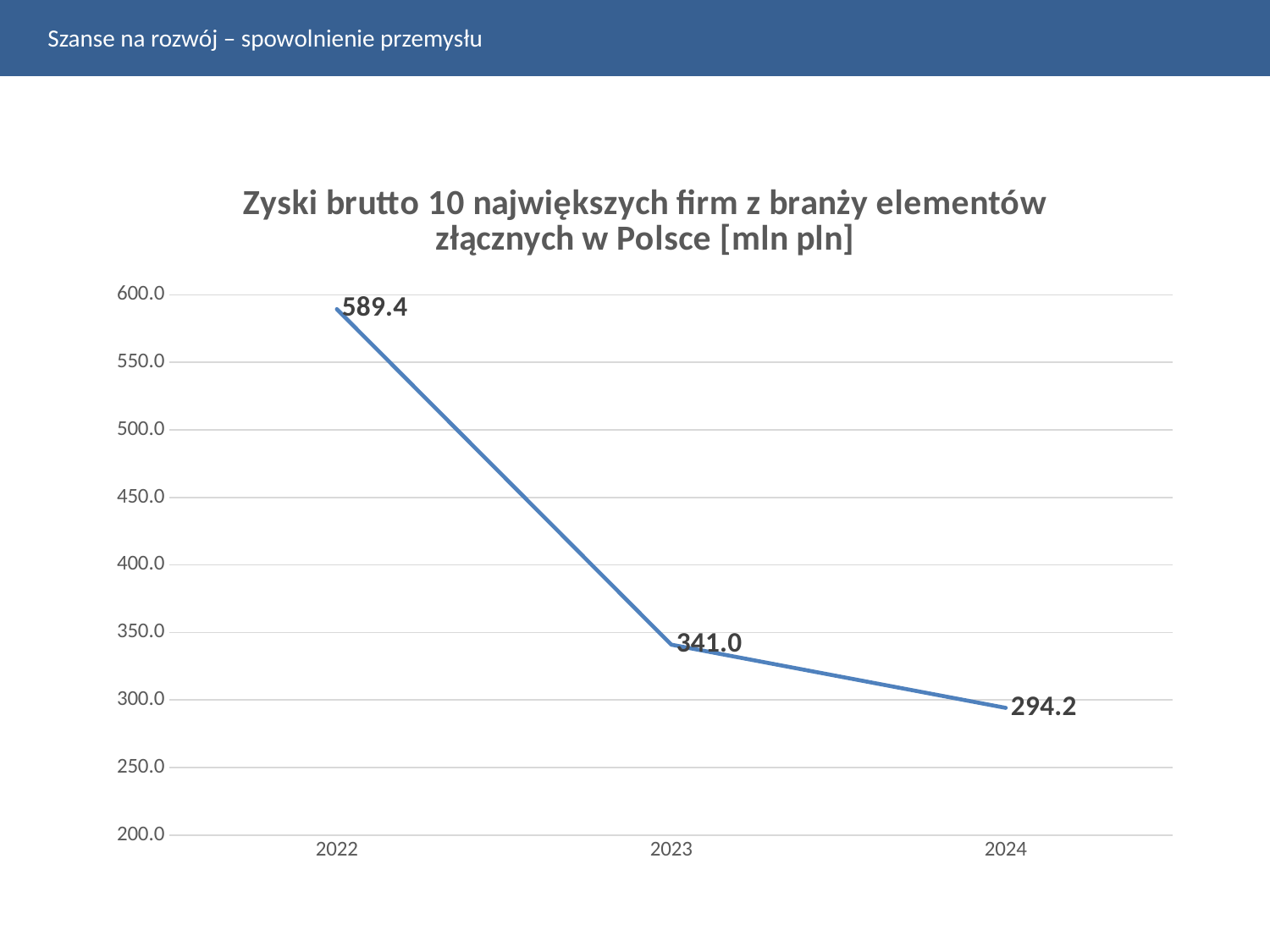
What kind of chart is shown on the slide? line chart What is the value for 2022? 589.4 How many years are plotted on the chart? 3 Which year has the highest value? 2022 What is the value for 2024? 294.2 Which year has the lowest value? 2024 Do the values rise or fall from 2022 to 2024? fall Is the value for 2024 greater or less than 300.0? less Which is larger, the value for 2023 or the value for 2024? 2023 What is the difference between the values for 2023 and 2024? 46.8 What is the difference between the values for 2022 and 2023? 248.4 What is the value for 2023? 341.0